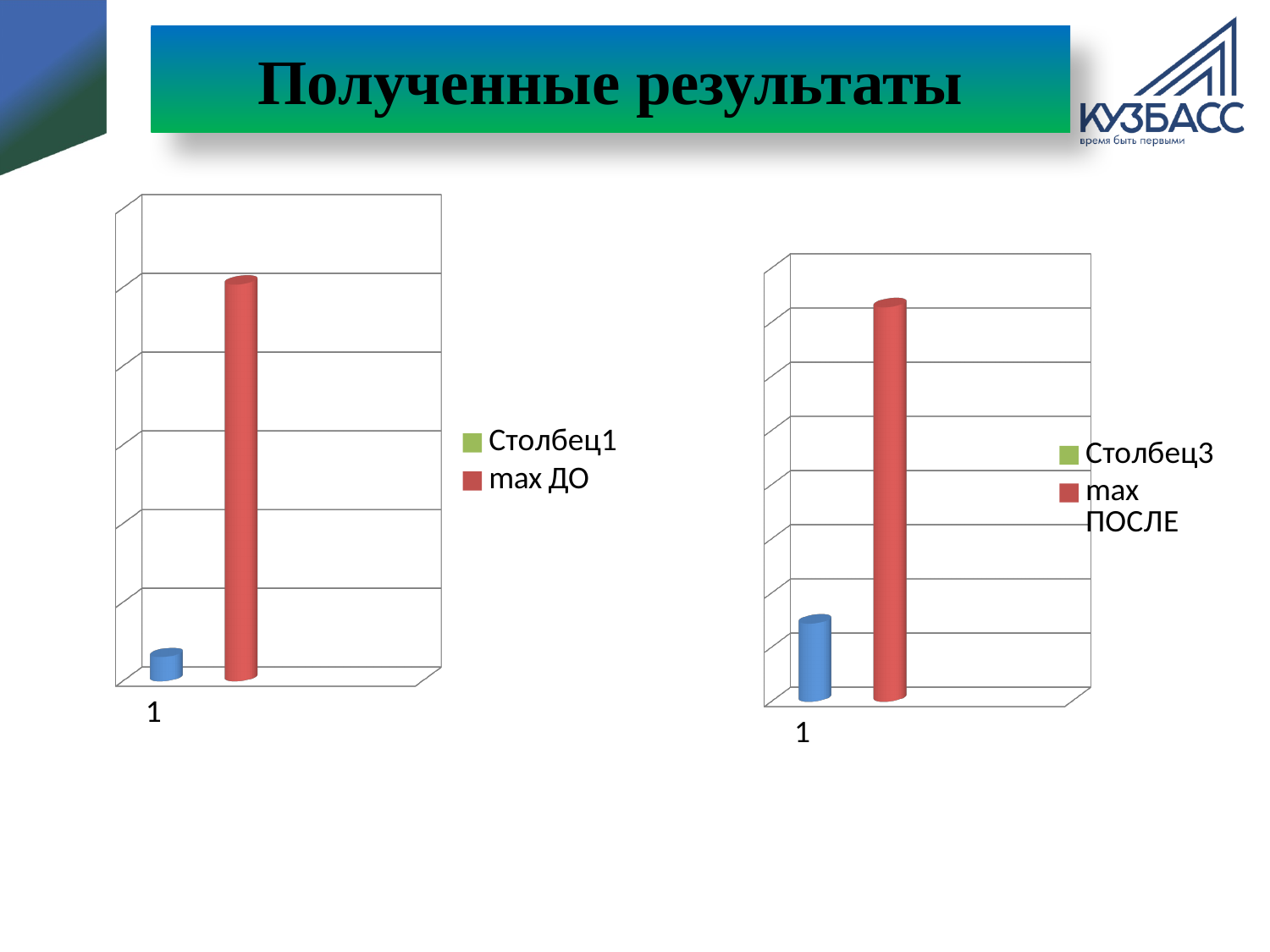
What kind of chart is the left chart on the slide? bar chart What is the category label on the x axis of the right chart? 1 In the left chart, what is the name of the series shown in red in the legend? max ДО In the right chart, which bar is taller, the red bar or the blue bar? the red bar In the right chart, what is the name of the series shown in red in the legend? max ПОСЛЕ What kind of chart is the right chart on the slide? bar chart In the left chart, how many categories are shown on the x axis? 1 In the left chart, how many series does the legend list? 2 In the right chart, how many categories are shown on the x axis? 1 In the right chart, how many series does the legend list? 2 In the left chart, which bar is taller, the red bar or the blue bar? the red bar